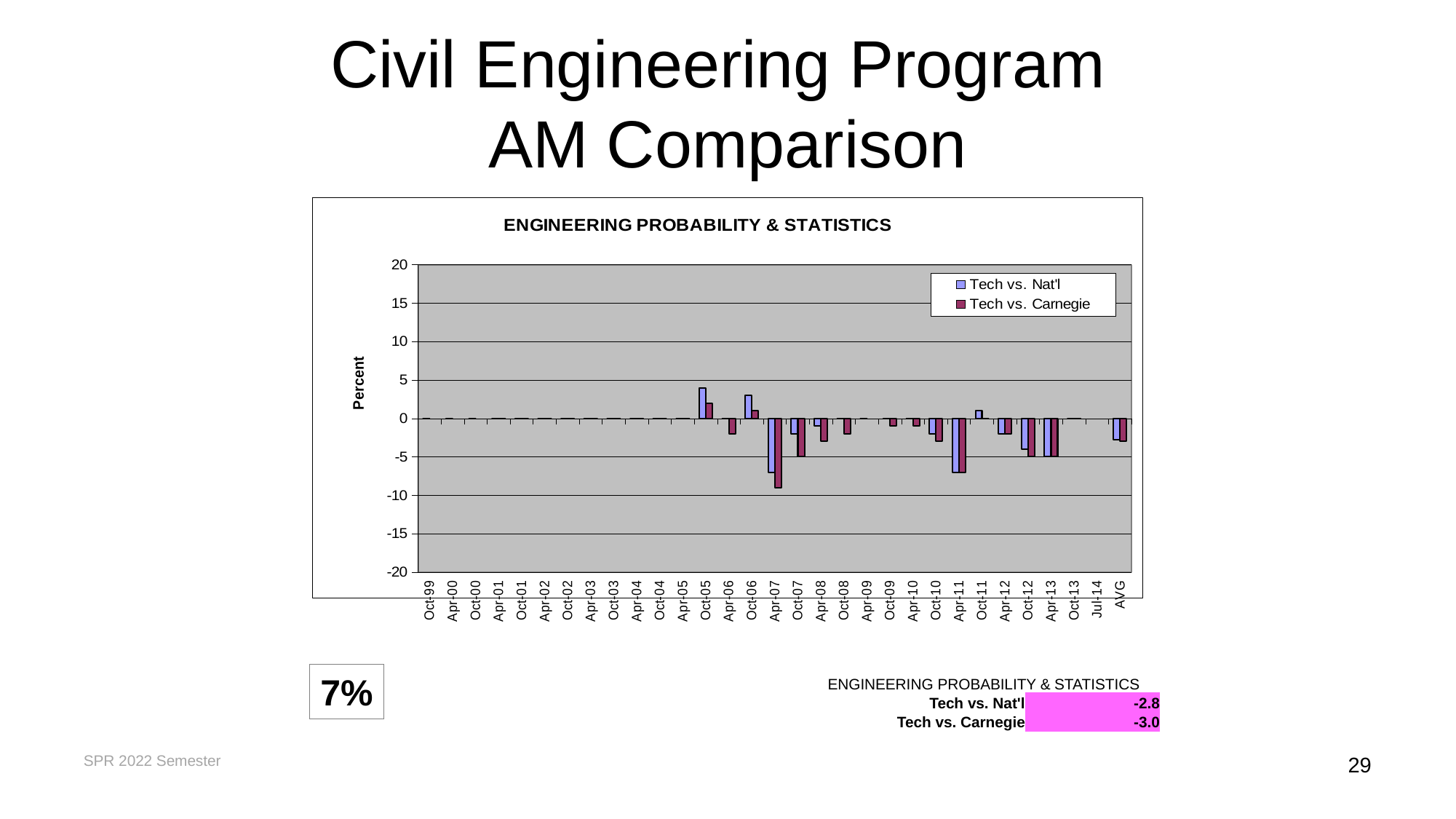
What is the label on the vertical axis? Percent In which period is the Tech vs. Nat'l value highest? Oct-05 What is the AVG value for Tech vs. Carnegie? -3.0 What is the title of the chart? ENGINEERING PROBABILITY & STATISTICS How many series does the legend list? 2 For Oct-05, which is larger: Tech vs. Nat'l or Tech vs. Carnegie? Tech vs. Nat'l What is the AVG value for Tech vs. Nat'l? -2.8 What is the difference between the AVG values for Tech vs. Nat'l and Tech vs. Carnegie? 0.2 In which period is the Tech vs. Carnegie value lowest? Apr-07 Is the Tech vs. Carnegie value for Apr-07 greater or less than -5? less Is the Tech vs. Nat'l value for Oct-05 greater or less than 0? greater What kind of chart is shown on the slide? Bar chart